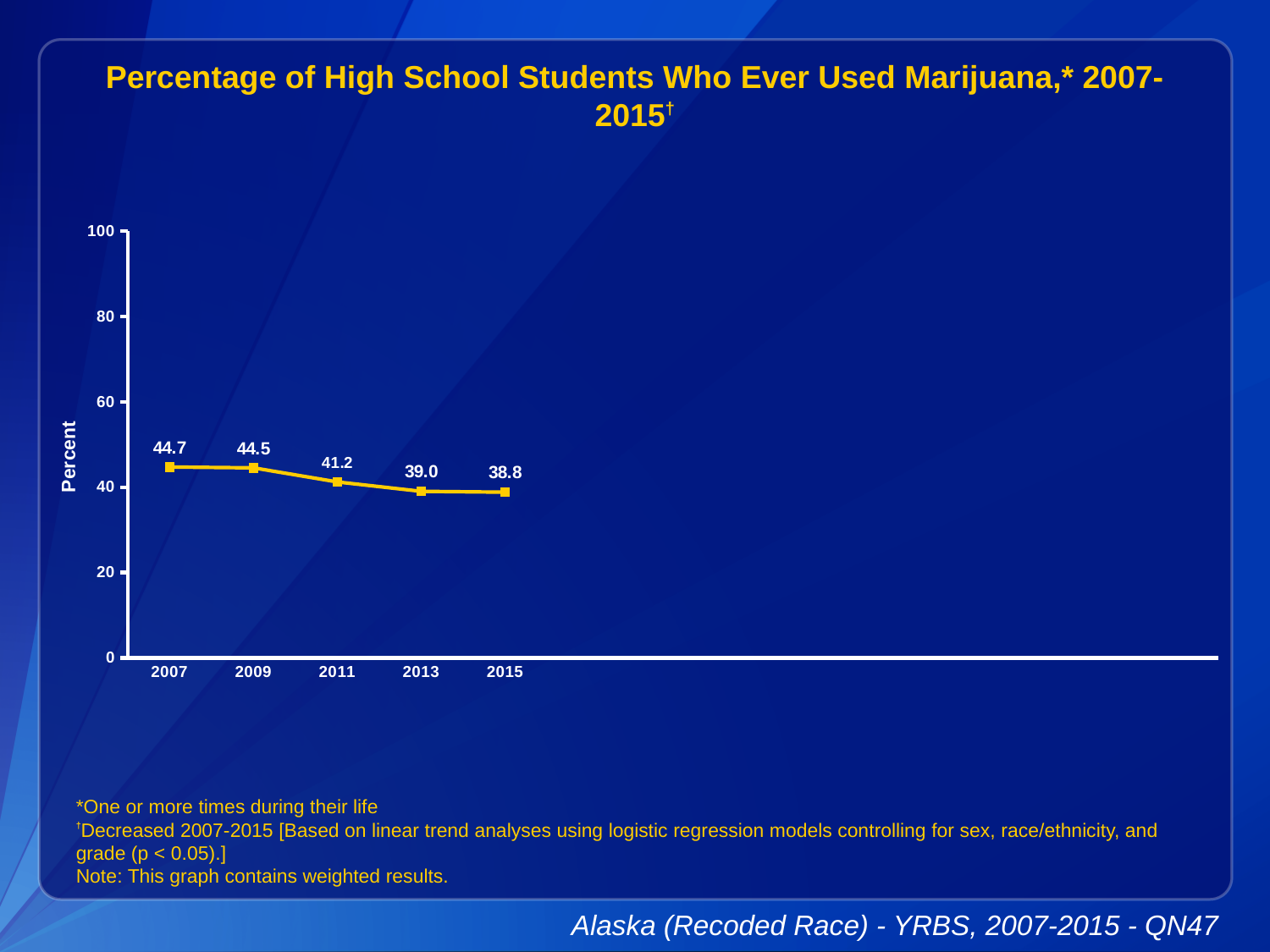
What was the percentage of high school students who ever used marijuana in 2007? 44.7 Which year had the lowest percentage of high school students who ever used marijuana? 2015 What kind of chart is shown on the slide? line chart What was the percentage of high school students who ever used marijuana in 2015? 38.8 How many years are plotted on the chart? 5 What is the difference between the 2007 value and the 2015 value? 5.9 What was the percentage of high school students who ever used marijuana in 2011? 41.2 Which year had a higher value, 2009 or 2013? 2009 Do the values rise or fall from 2007 to 2015? fall Which year had the highest percentage of high school students who ever used marijuana? 2007 Is the value for 2013 greater or less than 40? less What is the label on the y axis of the chart? Percent